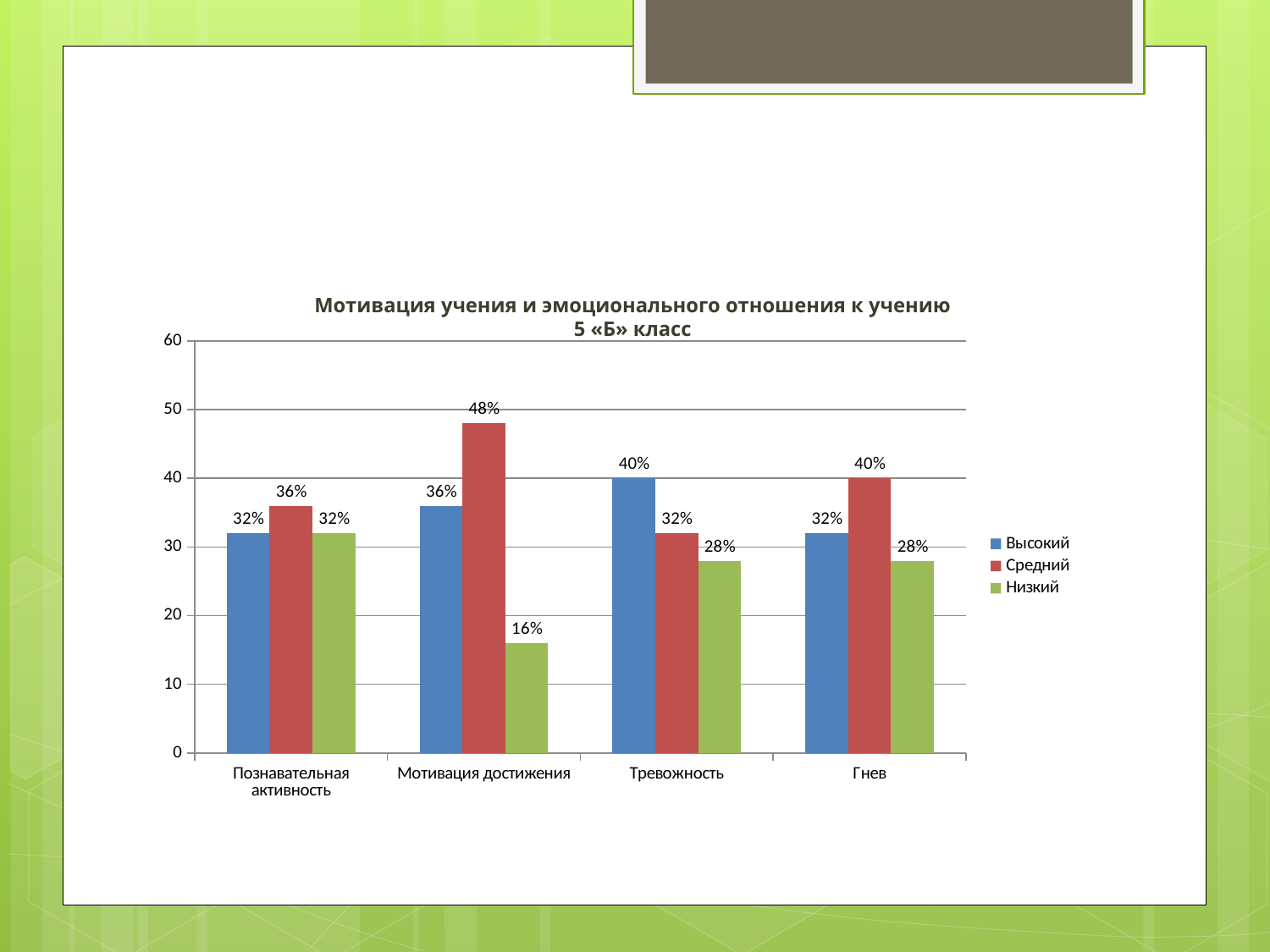
Which is larger for Тревожность: the Высокий value or the Низкий value? Высокий What is the value of the Высокий series for Тревожность? 40% What is the value of the Низкий series for Гнев? 28% How many categories are shown on the x axis? 4 What is the value of the Средний series for Мотивация достижения? 48% What is the value of the Низкий series for Мотивация достижения? 16% Which category has the highest Средний value? Мотивация достижения What colour represents the Средний series in the chart? Red What is the difference between the Средний and Низкий values for Мотивация достижения? 32% How many series does the legend list? 3 Which category has the lowest Низкий value? Мотивация достижения What kind of chart is shown on the slide? Bar chart